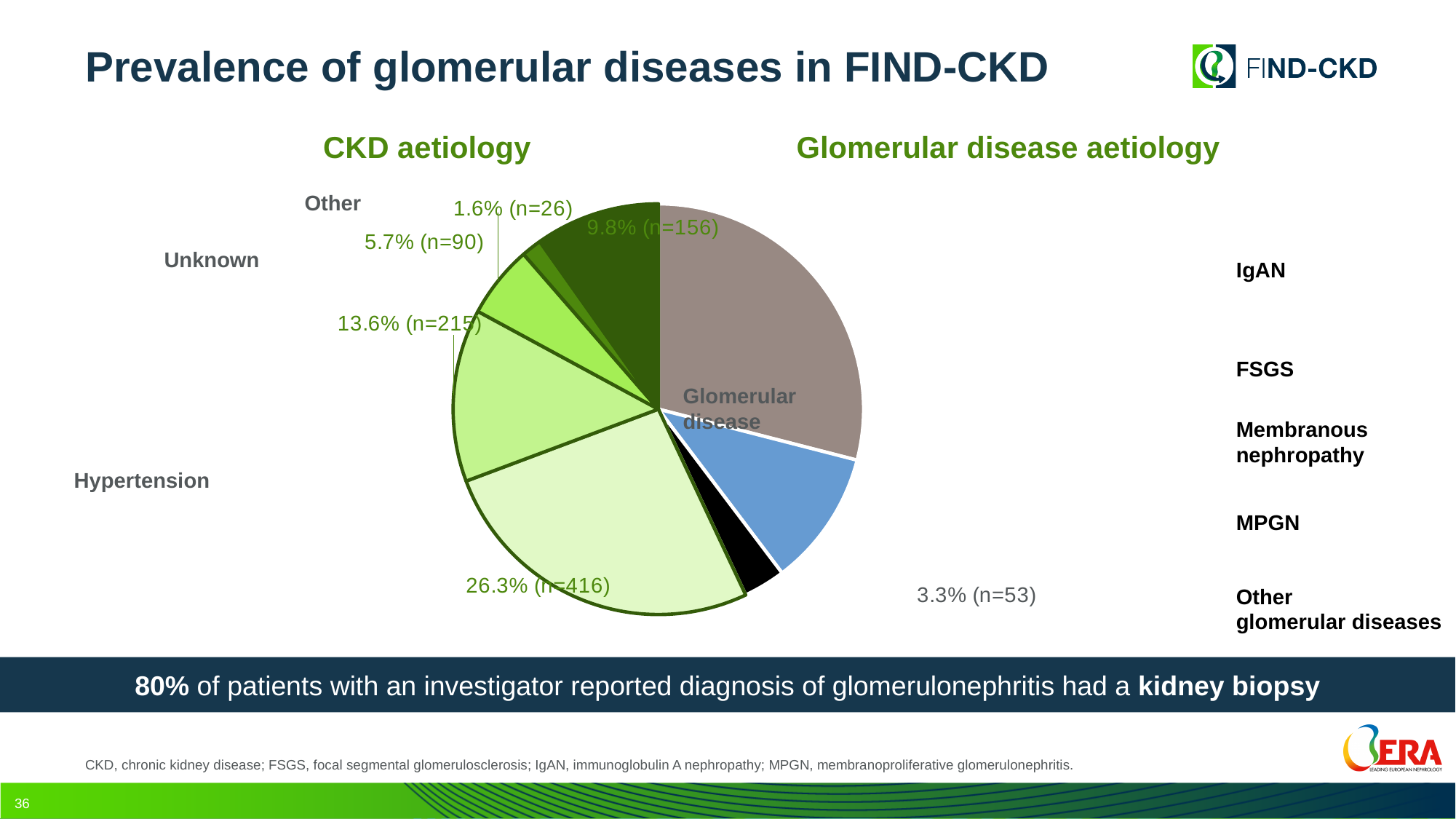
What is the smallest percentage printed on the pie chart? 1.6% (n=26) What percentage is printed for the slice with n=215? 13.6% How many glomerular disease categories are listed on the right side of the chart? 5 What type of chart is shown on the slide? Pie chart What is the n value printed for the 26.3% slice of the pie chart? n=416 What is the largest percentage printed on the pie chart? 26.3% (n=416) What is the difference in percentage points between the 26.3% slice and the 13.6% slice? 12.7 percentage points What are the two green subheadings above the chart? CKD aetiology; Glomerular disease aetiology What percentage is printed for the slice with n=53? 3.3% What label is printed inside the grey slice of the pie chart? Glomerular disease What is the n value printed for the 9.8% slice of the pie chart? n=156 Which is larger, the slice labelled 9.8% (n=156) or the slice labelled 5.7% (n=90)? 9.8% (n=156)